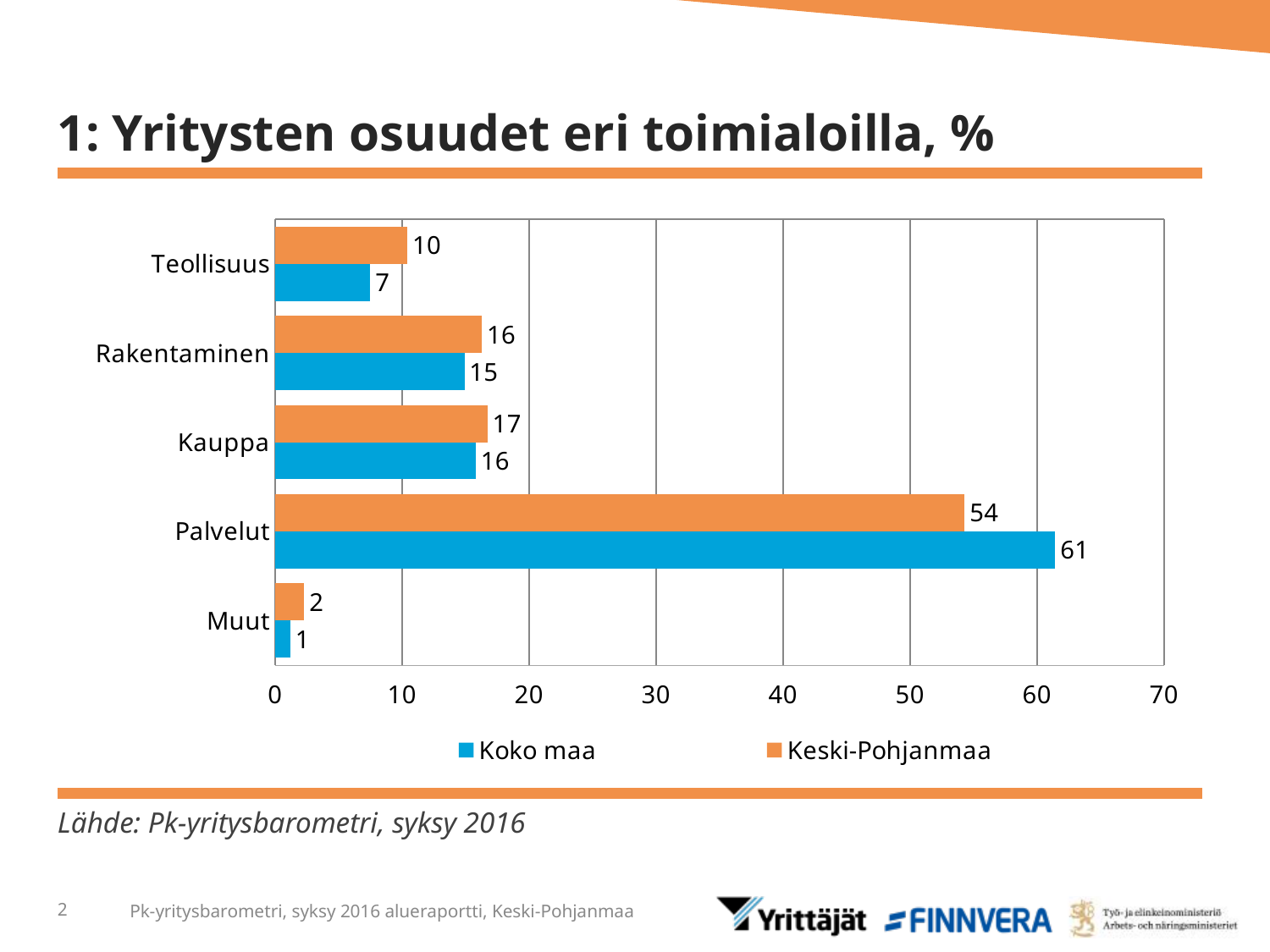
How many series does the legend list? 2 What colour represents the Keski-Pohjanmaa series? orange What is the value for Rakentaminen in the Koko maa series? 15 For Teollisuus, which series has the larger value, Koko maa or Keski-Pohjanmaa? Keski-Pohjanmaa What is the difference between the Koko maa and Keski-Pohjanmaa values for Palvelut? 7 What is the value for Palvelut in the Koko maa series? 61 Is the Koko maa value for Palvelut greater or less than 50? greater Which category has the lowest value in the Koko maa series? Muut What kind of chart is shown on the slide? bar chart How many categories are shown on the chart? 5 Which category has the highest value in the Keski-Pohjanmaa series? Palvelut What is the value for Teollisuus in the Keski-Pohjanmaa series? 10